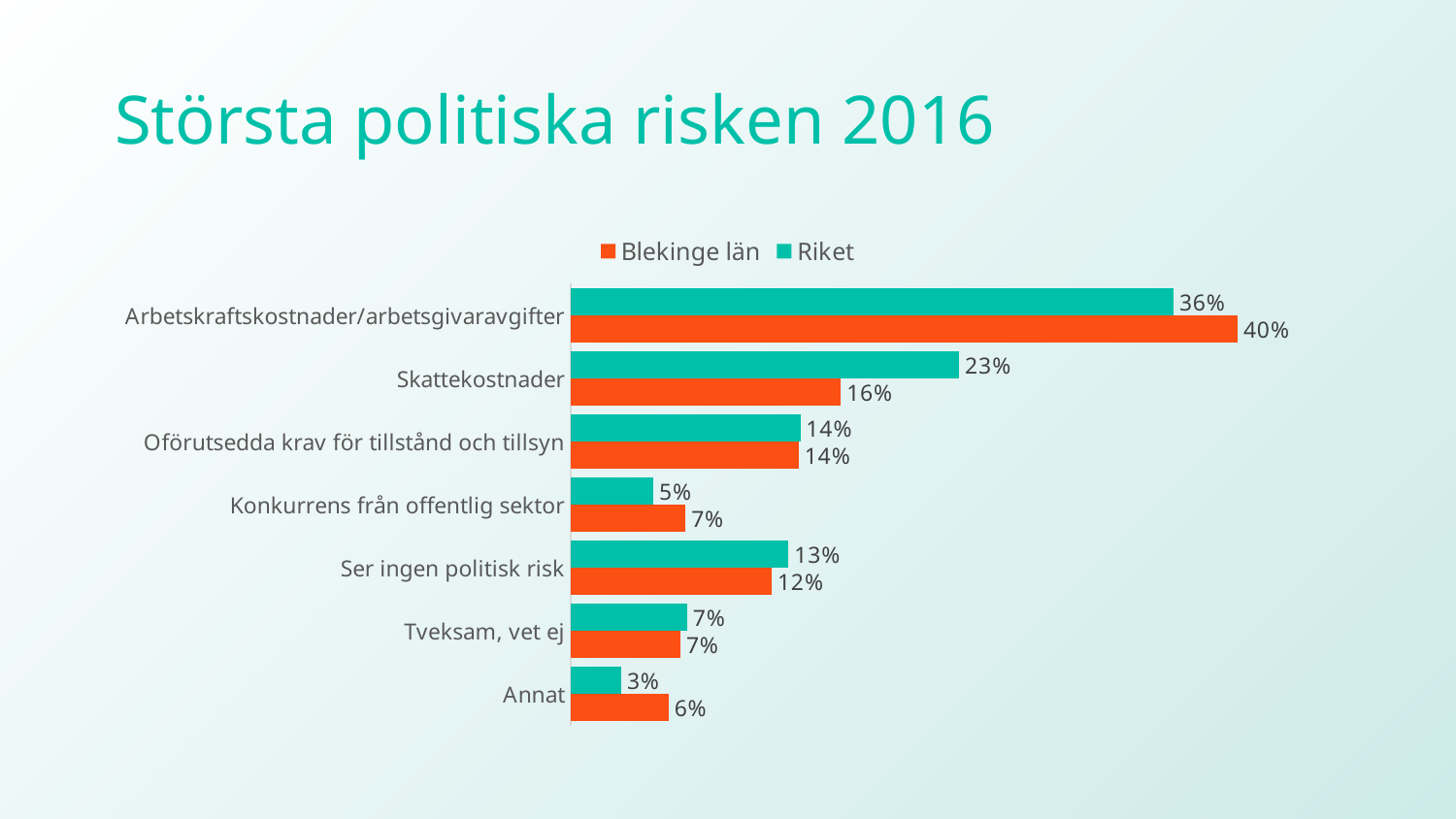
What kind of chart is shown on the slide? Bar chart What is the value for Blekinge län for Arbetskraftskostnader/arbetsgivaravgifter? 40% What is the value for Riket for Skattekostnader? 23% Which category has the lowest value for Riket? Annat What is the value for Blekinge län for Annat? 6% Which is larger for Konkurrens från offentlig sektor, Blekinge län or Riket? Blekinge län How many series does the legend list? 2 What is the difference between Blekinge län and Riket for Skattekostnader? 7% How many categories are shown in the chart? 7 What is the difference between Blekinge län and Riket for Arbetskraftskostnader/arbetsgivaravgifter? 4% What is the title of the slide? Största politiska risken 2016 Which category has the highest value for Riket? Arbetskraftskostnader/arbetsgivaravgifter